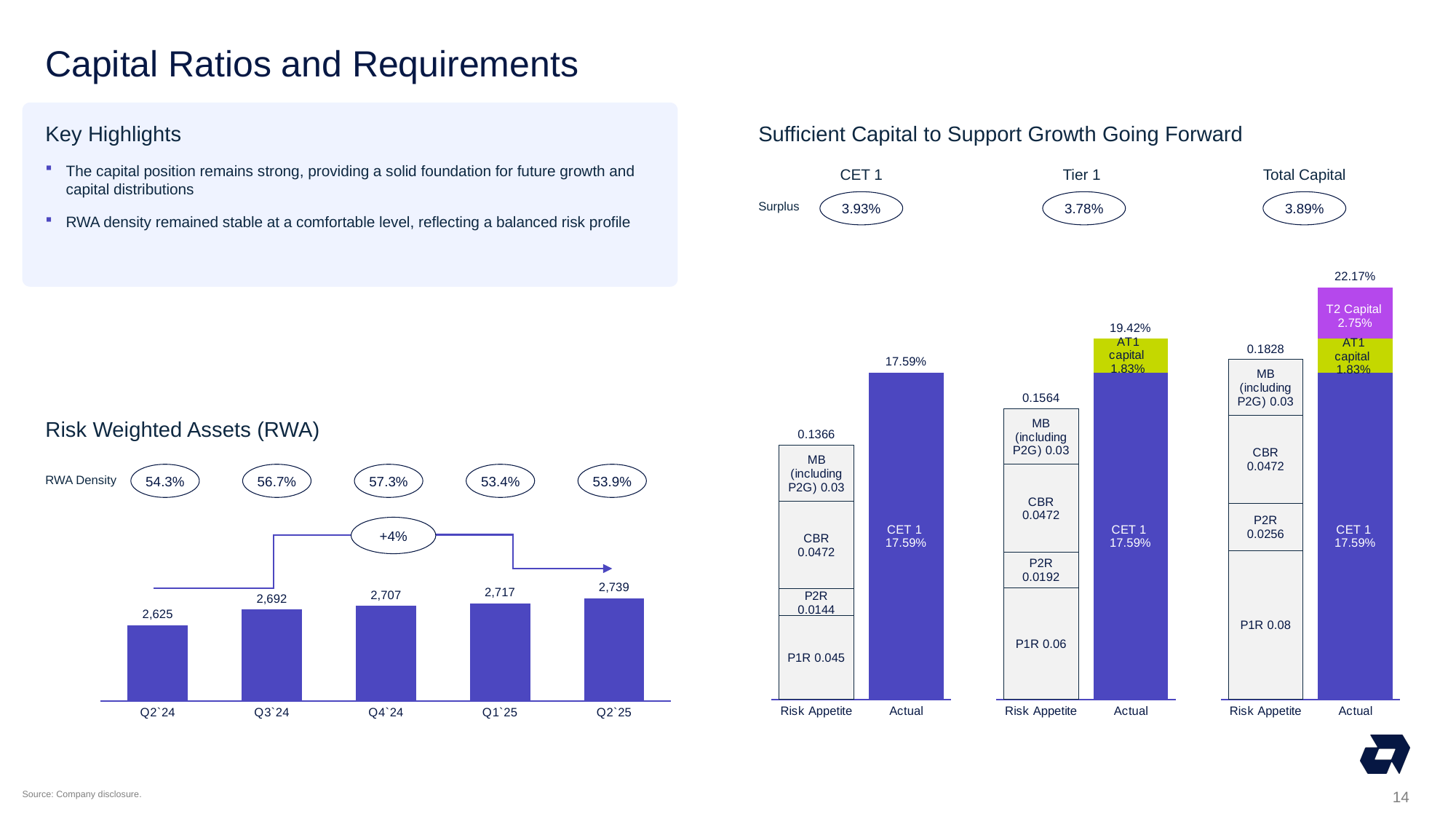
In the Risk Weighted Assets (RWA) chart, what is the difference between the Q2`25 and Q2`24 values? 114 In the Sufficient Capital to Support Growth Going Forward chart, what is the total of the Total Capital Actual bar? 22.17% In the Sufficient Capital to Support Growth Going Forward chart, what is the T2 Capital value in the Total Capital Actual bar? 2.75% In the Risk Weighted Assets (RWA) chart, do the values rise or fall from Q2`24 to Q2`25? Rise What kind of chart is the Risk Weighted Assets (RWA) chart? Bar chart In the Risk Weighted Assets (RWA) chart, which quarter has the highest value? Q2`25 In the Risk Weighted Assets (RWA) chart, what is the value for Q2`25? 2,739 How many quarters are shown in the Risk Weighted Assets (RWA) chart? 5 In the Sufficient Capital to Support Growth Going Forward chart, what is the AT1 capital value in the Tier 1 Actual bar? 1.83% In the Risk Weighted Assets (RWA) chart, which quarter has the lowest value? Q2`24 In the Sufficient Capital to Support Growth Going Forward chart, what is the total of the Tier 1 Risk Appetite bar? 0.1564 In the Sufficient Capital to Support Growth Going Forward chart, which is larger: the Tier 1 Actual bar or the Total Capital Actual bar? Total Capital Actual